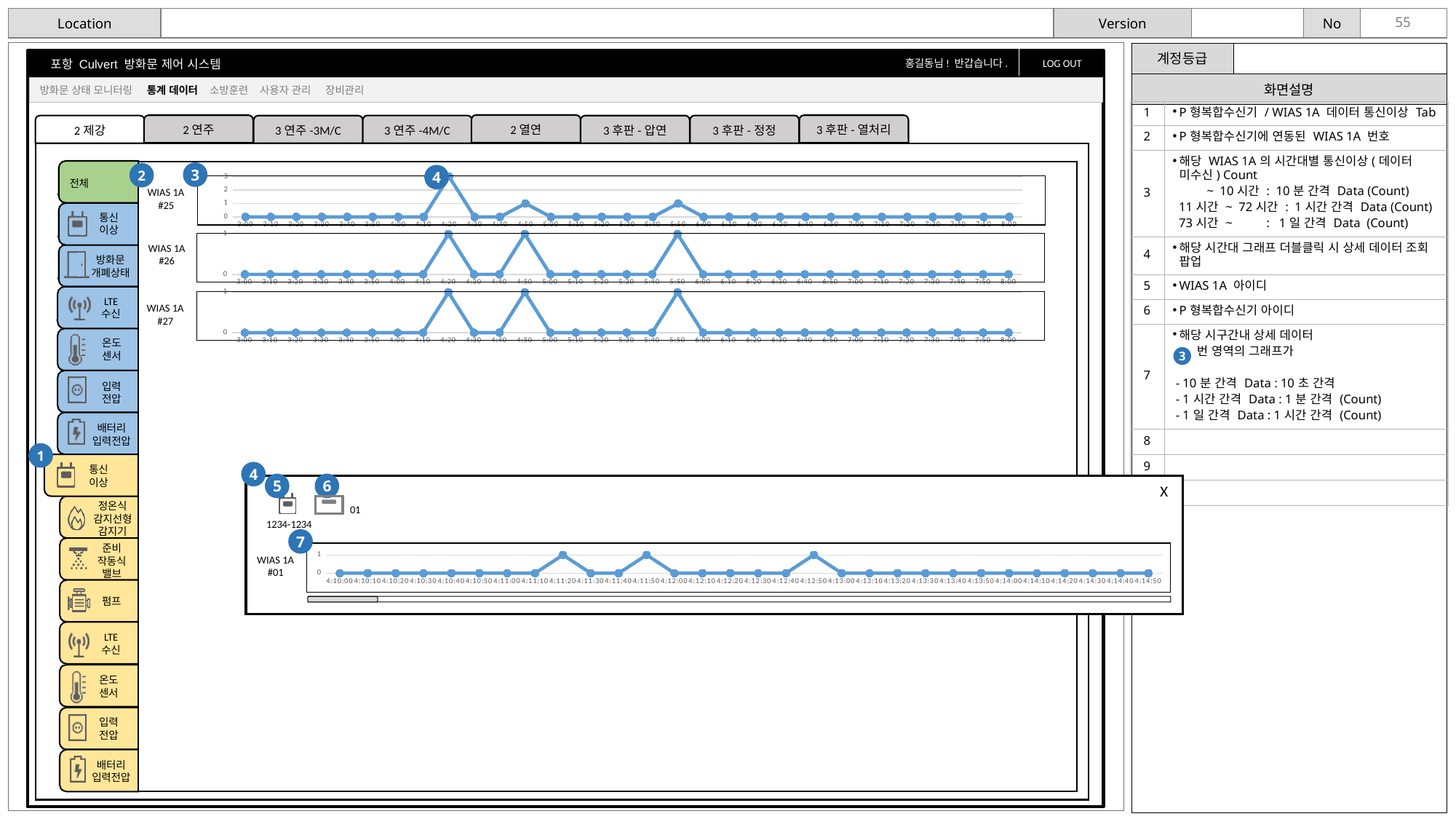
In the WIAS 1A #01 chart in the popup, what is the value at 4:10:00? 0 In the WIAS 1A #25 chart, what is the difference between the value at 4:20 and the value at 4:50? 2 In the WIAS 1A #01 chart in the popup, what is the value at 4:11:20? 1 In the WIAS 1A #25 chart, at which time is the value highest? 4:20 In the WIAS 1A #25 chart, which is larger, the value at 4:20 or the value at 4:50? 4:20 In the WIAS 1A #27 chart, what is the value at 6:00? 0 What kind of chart is used for WIAS 1A #25? line chart In the WIAS 1A #25 chart, what is the value at 4:20? 3 In the WIAS 1A #26 chart, what is the value at 4:50? 1 What is the highest tick shown on the y axis of the WIAS 1A #25 chart? 3 In the WIAS 1A #27 chart, what is the value at 5:50? 1 In the WIAS 1A #25 chart, what is the value at 3:00? 0